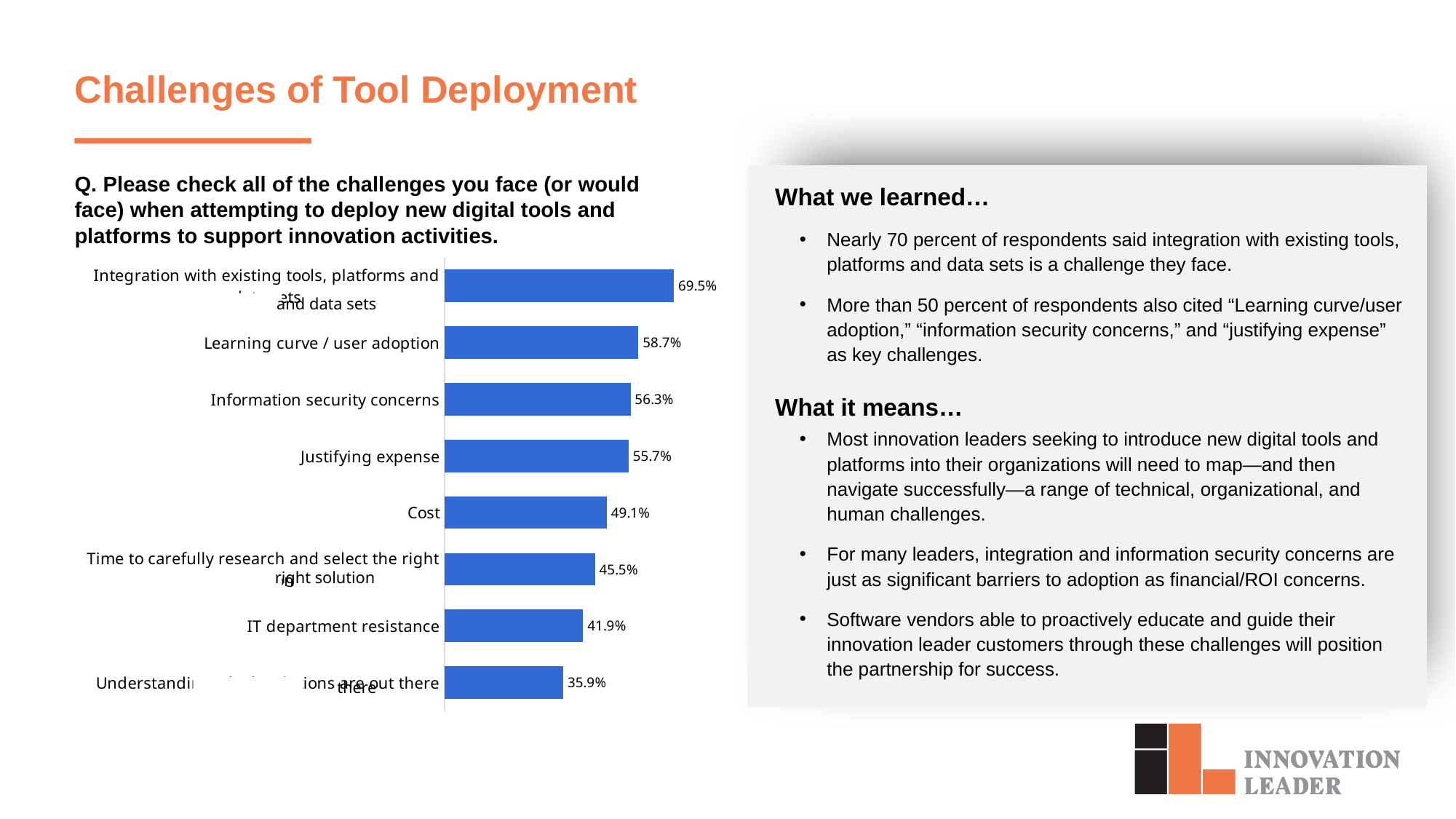
What is the value shown for IT department resistance? 41.9% What type of chart is shown on the slide? Bar chart What colour are the bars in the chart? Blue Which challenge has the highest percentage in the chart? Integration with existing tools, platforms and data sets What is the value shown for Learning curve / user adoption? 58.7% What is the value shown for Information security concerns? 56.3% How many challenges (categories) are plotted in the chart? 8 Which is larger: the value for Cost or the value for Time to carefully research and select the right solution? Cost What is the lowest percentage value shown in the chart? 35.9% What percentage of respondents cited integration with existing tools, platforms and data sets as a challenge? 69.5% What is the difference between the values for Learning curve / user adoption and Information security concerns? 2.4% What is the difference between the values for Justifying expense and Cost? 6.6%